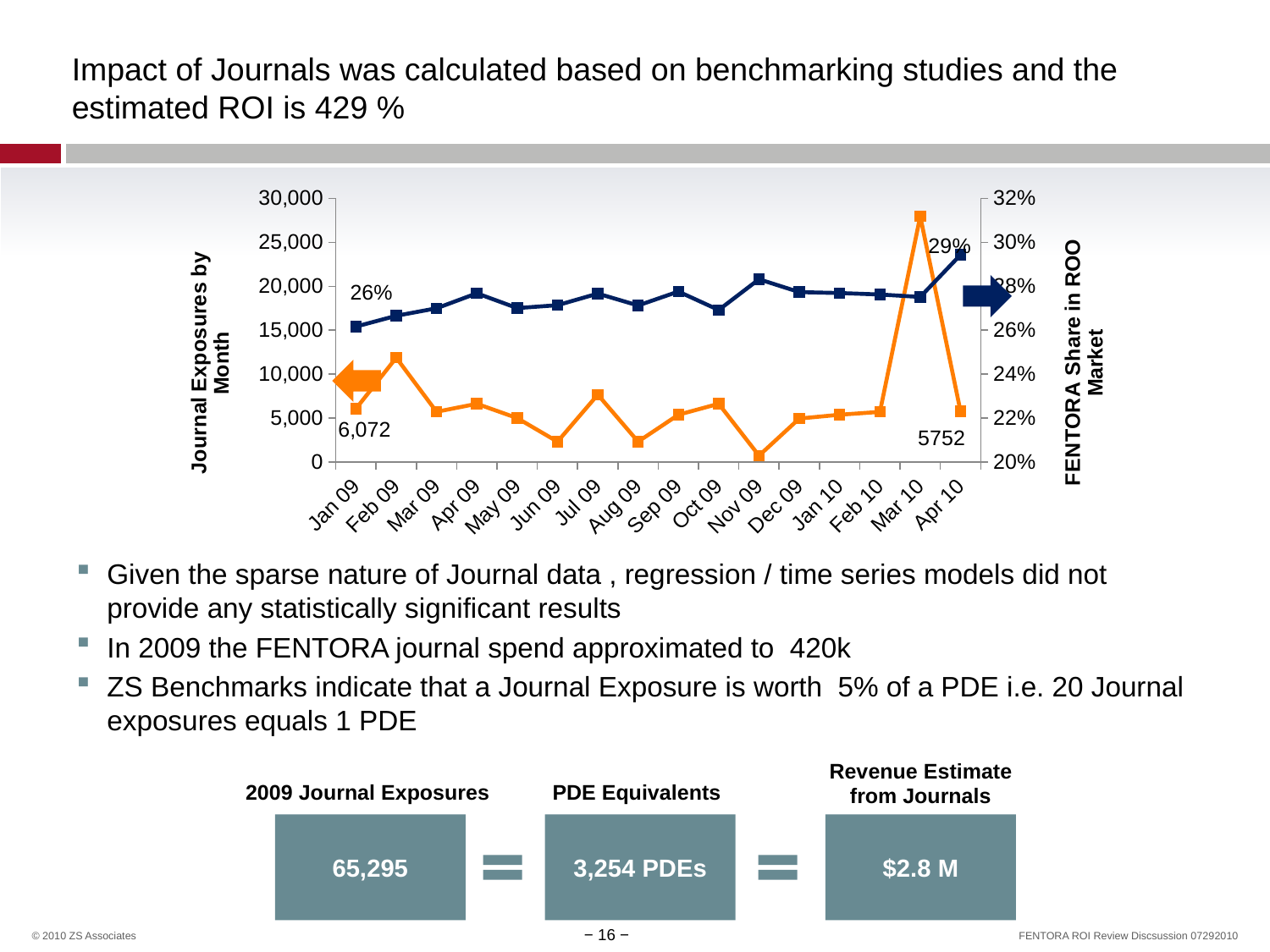
Is the value of Journal Exposures for Mar 10 greater or less than 25,000? greater How many months are plotted along the x axis of the chart? 16 Which month has the lowest Journal Exposures? Nov 09 What is the value of Journal Exposures for Apr 10? 5752 Which month has the highest Journal Exposures? Mar 10 What is the FENTORA Share in ROO Market for Jan 09? 26% What is the FENTORA Share in ROO Market for Apr 10? 29% Which is larger, the Journal Exposures for Jan 09 or for Apr 10? Jan 09 What is the value of Journal Exposures for Jan 09? 6,072 Does the FENTORA Share in ROO Market rise or fall from Jan 09 to Apr 10? Rise What is the difference between the Journal Exposures for Jan 09 and Apr 10? 320 What kind of chart is shown on the slide? Line chart